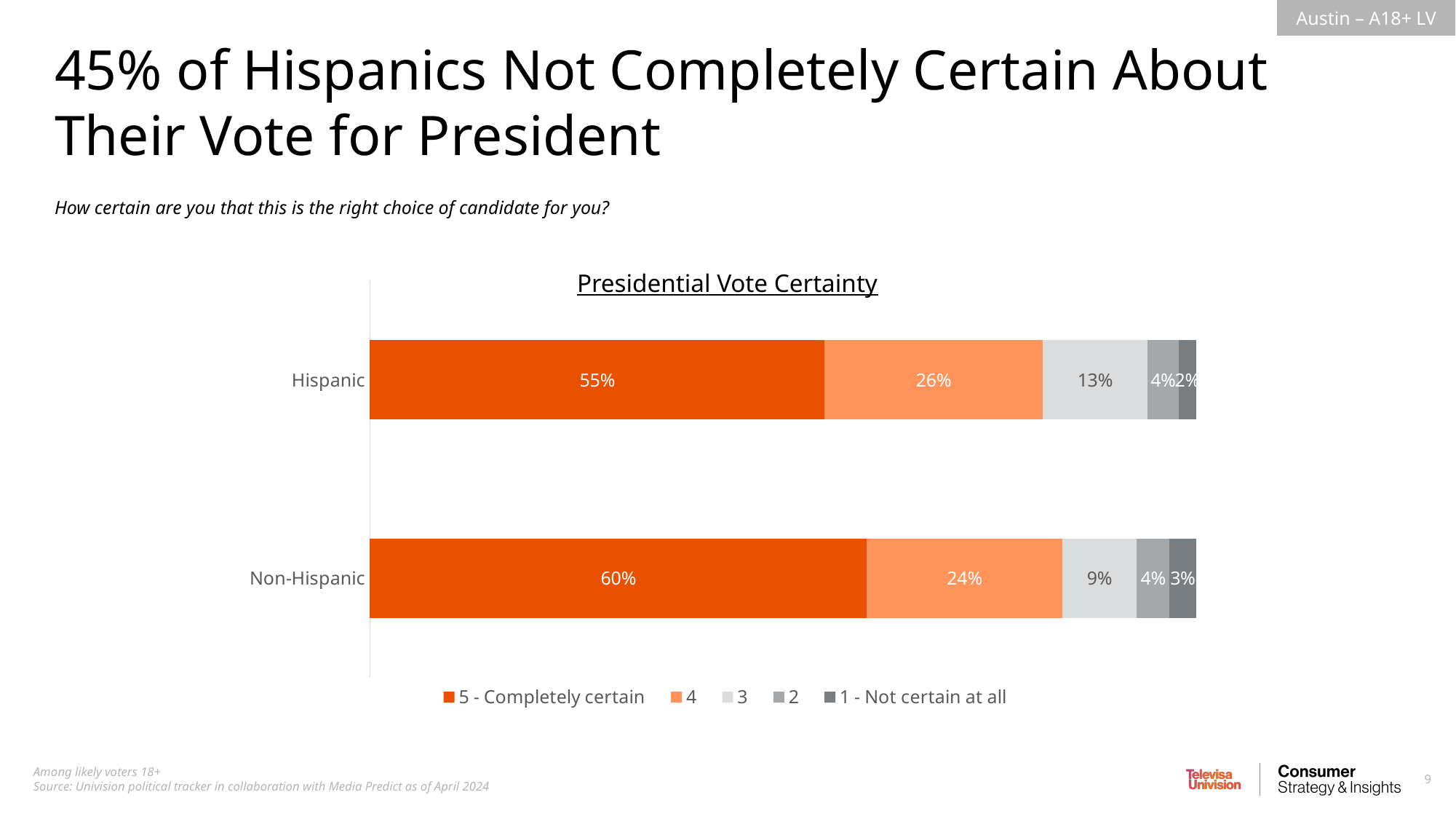
Which certainty level has the highest share among Hispanic respondents? 5 - Completely certain What percentage of Non-Hispanic respondents are '1 - Not certain at all'? 3% What percentage of Hispanic respondents gave a rating of 3? 13% What percentage of Non-Hispanic respondents are '5 - Completely certain'? 60% What is the difference between the Non-Hispanic and Hispanic shares for '5 - Completely certain'? 5% Which certainty level has the lowest share among Hispanic respondents? 1 - Not certain at all What percentage of Hispanic respondents are '5 - Completely certain' about their vote for President? 55% Which group has the larger share rating 3: Hispanic or Non-Hispanic? Hispanic How many series does the legend list? 5 How many groups (categories) are shown on the chart? 2 What type of chart is shown on the slide? Stacked bar chart Which group has the larger share rating 4: Hispanic or Non-Hispanic? Hispanic